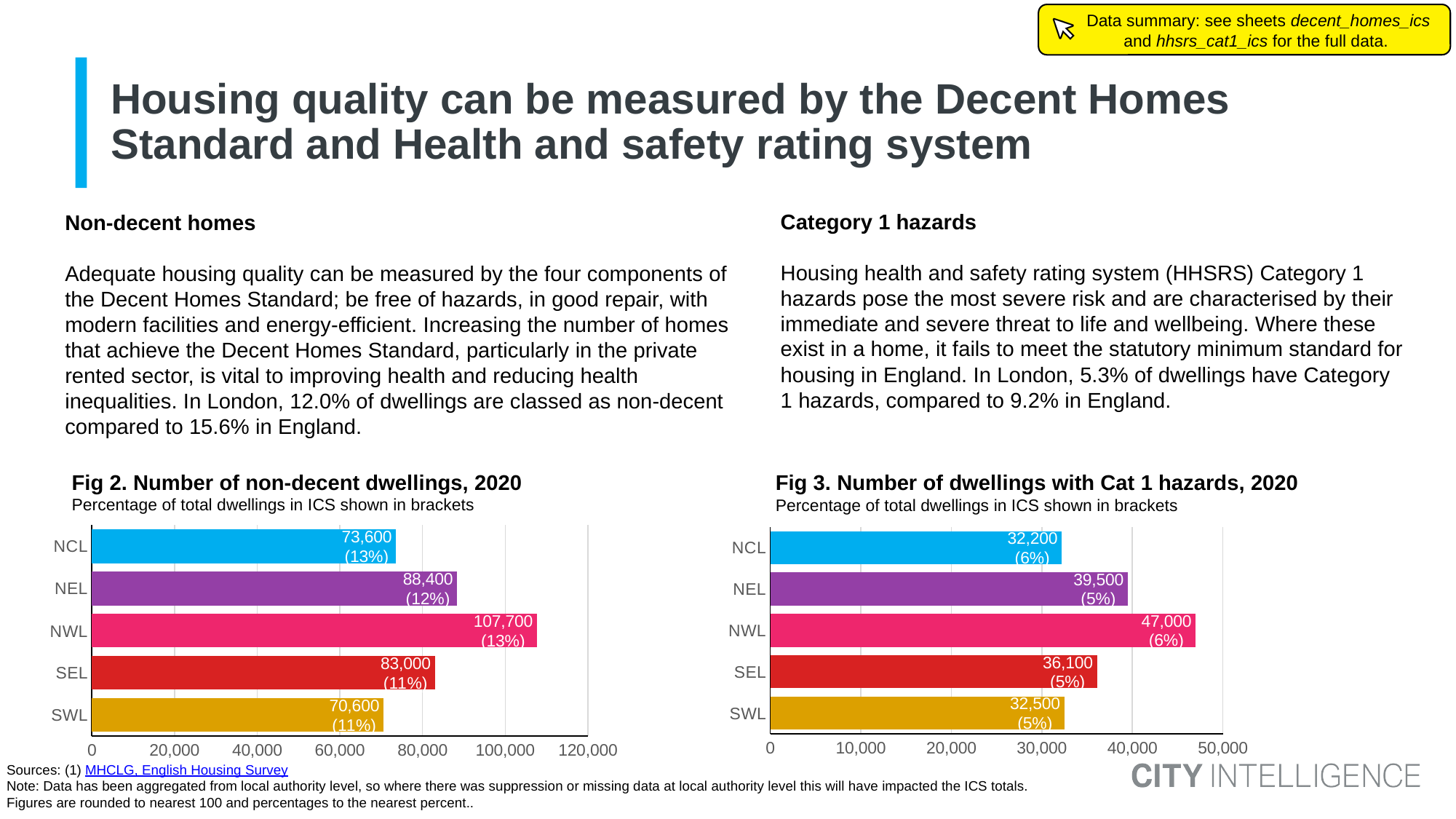
In Fig 2 (Number of non-decent dwellings, 2020), is the value for SEL greater or less than 80,000? greater In Fig 2 (Number of non-decent dwellings, 2020), which category has the lowest value? SWL How many categories are shown in Fig 3 (Number of dwellings with Cat 1 hazards, 2020)? 5 What is the subtitle shown under the title of Fig 3? Percentage of total dwellings in ICS shown in brackets What type of chart is Fig 2 (Number of non-decent dwellings, 2020)? Bar chart In Fig 2 (Number of non-decent dwellings, 2020), what percentage is shown in brackets for SEL? 11% In Fig 3 (Number of dwellings with Cat 1 hazards, 2020), which is larger, SEL or SWL? SEL In Fig 3 (Number of dwellings with Cat 1 hazards, 2020), what is the value for NEL? 39,500 In Fig 2 (Number of non-decent dwellings, 2020), what is the difference between NEL and NCL? 14,800 In Fig 3 (Number of dwellings with Cat 1 hazards, 2020), what is the difference between NWL and NCL? 14,800 In Fig 2 (Number of non-decent dwellings, 2020), what is the value for NWL? 107,700 In Fig 3 (Number of dwellings with Cat 1 hazards, 2020), which category has the highest value? NWL